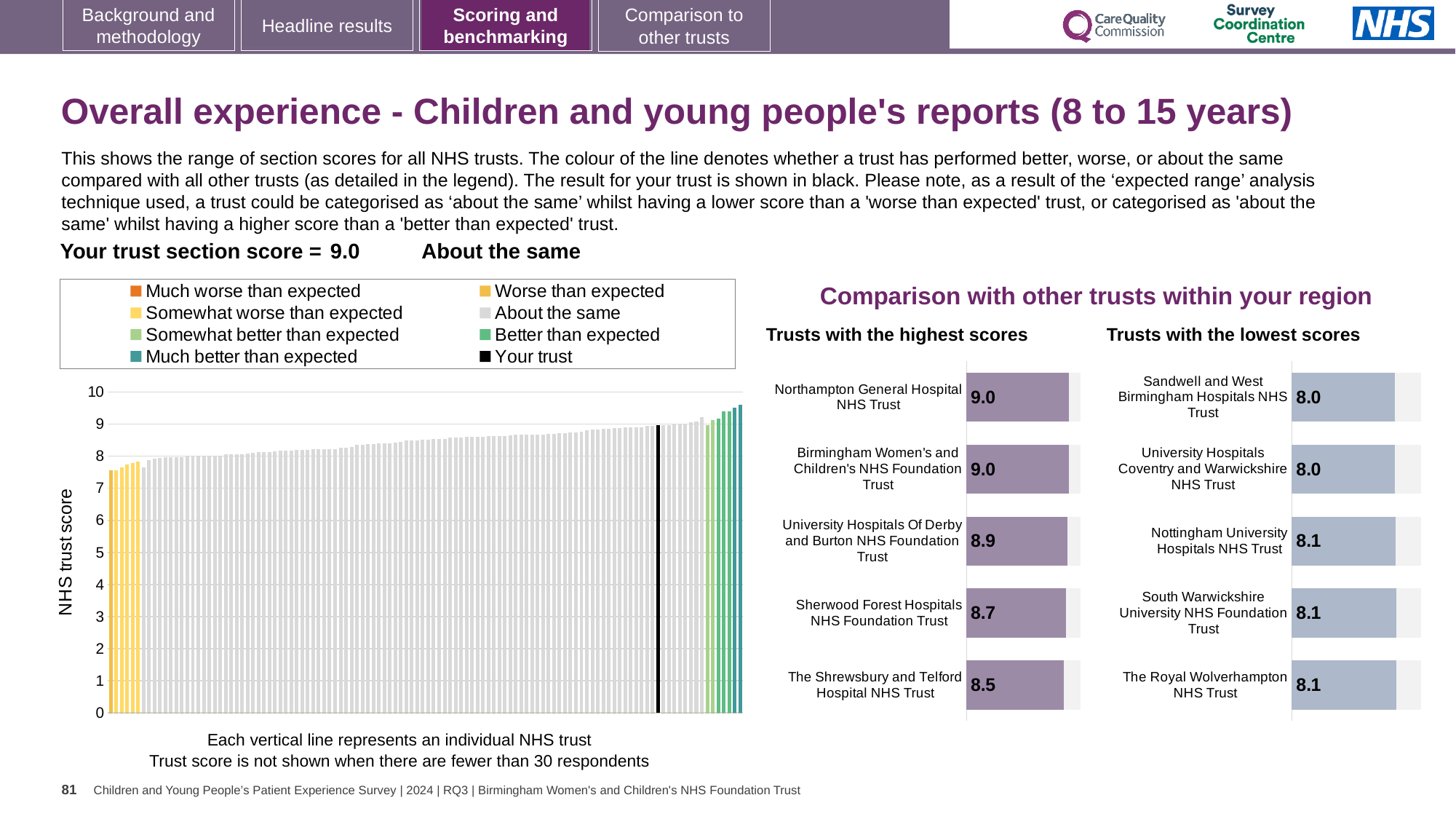
What type of chart is the large chart on the left showing NHS trust scores? Bar chart In the 'Trusts with the lowest scores' chart, what is the score for Sandwell and West Birmingham Hospitals NHS Trust? 8.0 In the 'Trusts with the highest scores' chart, which has the higher score: University Hospitals Of Derby and Burton NHS Foundation Trust or Sherwood Forest Hospitals NHS Foundation Trust? University Hospitals Of Derby and Burton NHS Foundation Trust In the 'Trusts with the highest scores' chart, what is the score for The Shrewsbury and Telford Hospital NHS Trust? 8.5 In the 'Trusts with the lowest scores' chart, what is the score for Nottingham University Hospitals NHS Trust? 8.1 How many trusts are shown in the 'Trusts with the lowest scores' chart? 5 In the 'Trusts with the highest scores' chart, what is the score for Sherwood Forest Hospitals NHS Foundation Trust? 8.7 In the 'Trusts with the highest scores' chart, what is the difference between the scores of Northampton General Hospital NHS Trust and The Shrewsbury and Telford Hospital NHS Trust? 0.5 In the 'Trusts with the highest scores' chart, which trust has the lowest score? The Shrewsbury and Telford Hospital NHS Trust How many entries does the legend of the large chart on the left list? 8 In the large chart on the left, is the value for the leftmost (lowest) trust greater or less than 8? less In the large chart on the left, do the NHS trust scores rise or fall from left to right? Rise